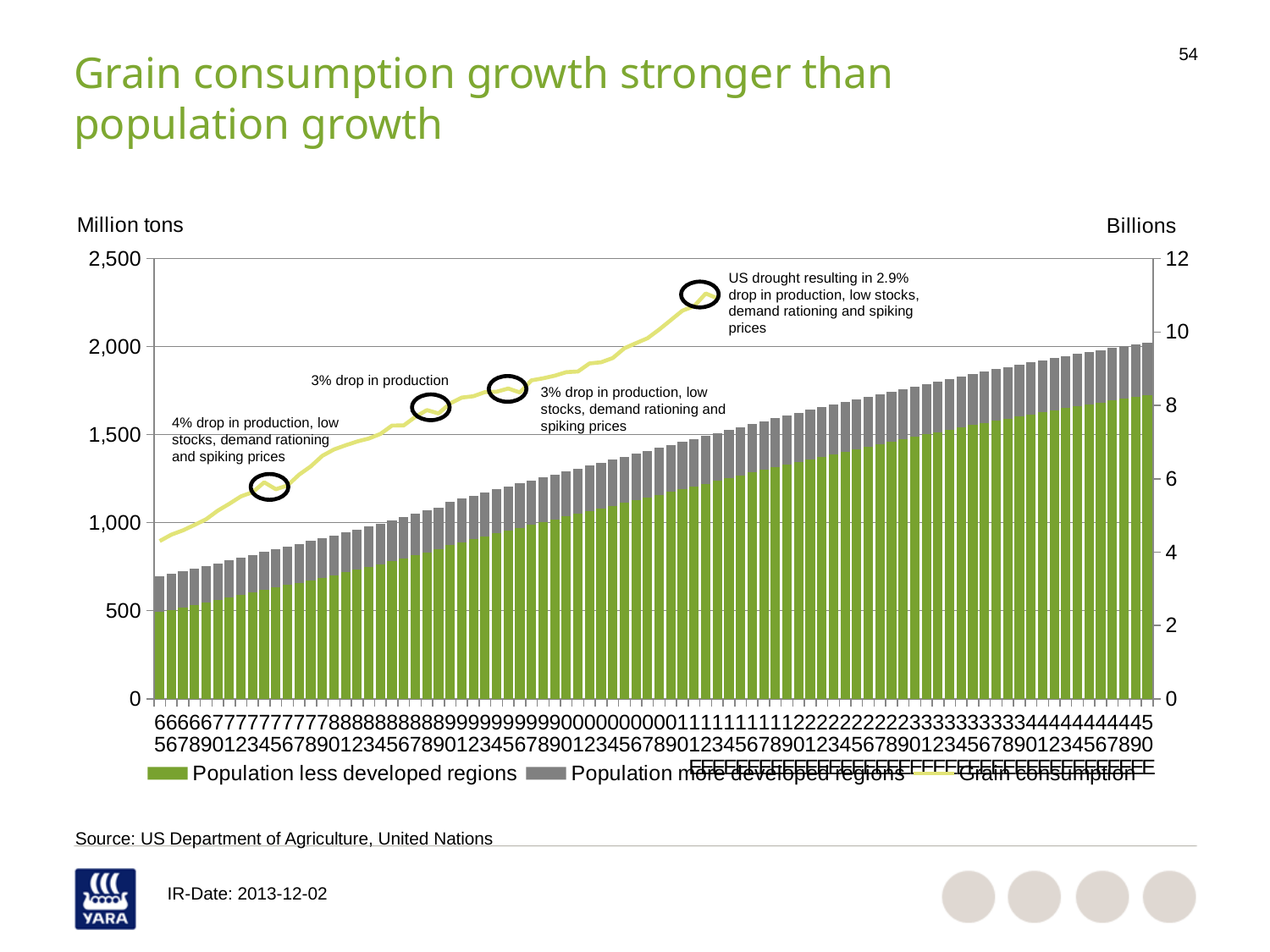
How many series does the chart legend list? 3 In the rightmost bar, which segment is larger: population less developed regions or population more developed regions? Population less developed regions Is the grain consumption value at the rightmost point of the line greater or less than 2,000 million tons? greater What unit is shown on the left vertical axis of the chart? Million tons Do the stacked population bars rise or fall from left to right along the x axis? Rise Does the grain consumption line rise or fall from left to right along the x axis? Rises What kind of chart is shown on the slide? Combined stacked bar and line chart Which series is plotted as a line rather than as bars? Grain consumption Is the grain consumption value at the leftmost point of the line greater or less than 1,000 million tons? less Is the total population (both stacked segments) of the leftmost bar greater or less than 4 billion? less What is the title of the chart on this slide? Grain consumption growth stronger than population growth